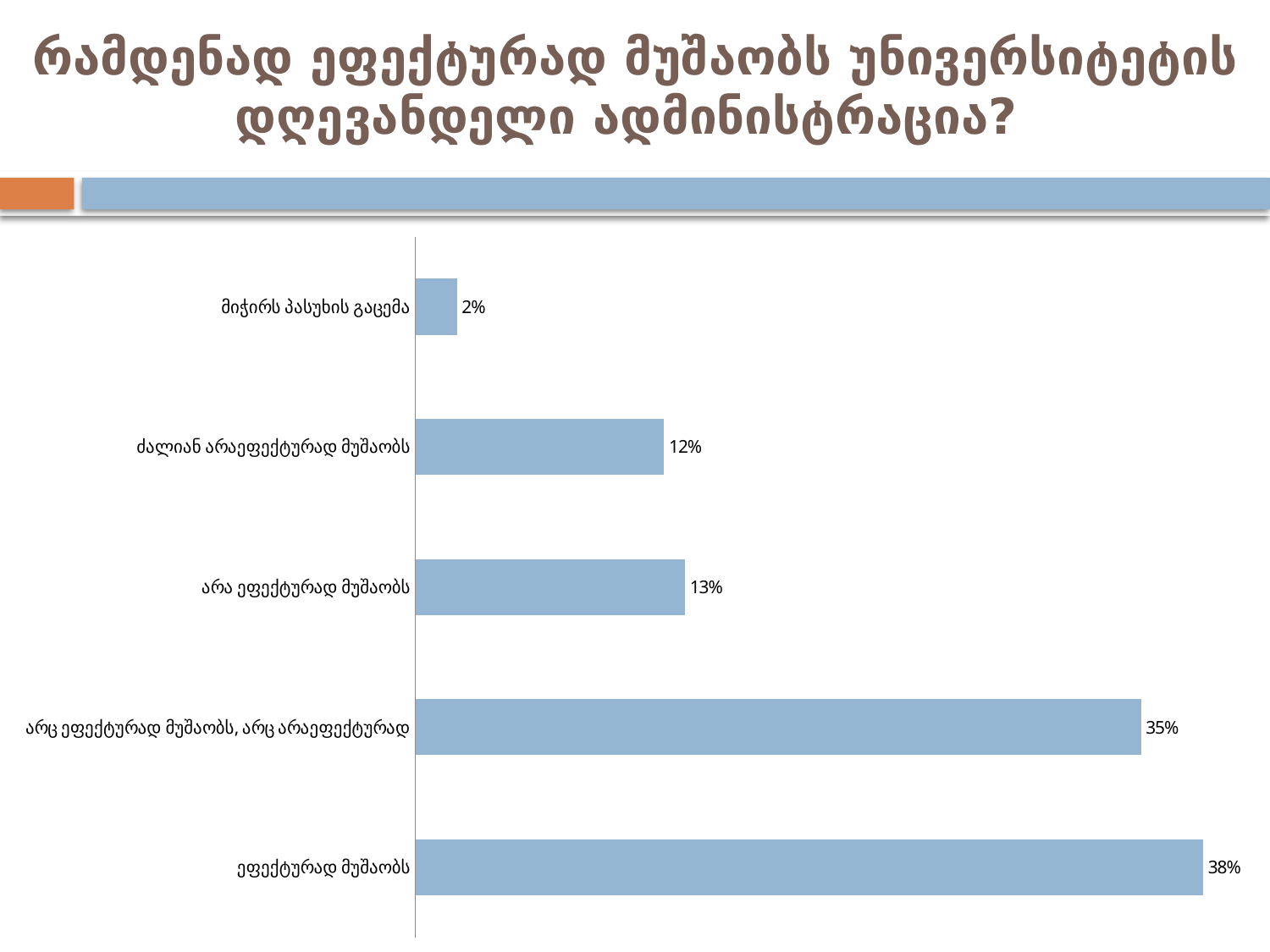
What value is shown for "არც ეფექტურად მუშაობს, არც არაეფექტურად"? 35% What is the difference between the values for "ეფექტურად მუშაობს" and "არც ეფექტურად მუშაობს, არც არაეფექტურად"? 3% What is the title of the slide? რამდენად ეფექტურად მუშაობს უნივერსიტეტის დღევანდელი ადმინისტრაცია? How many categories are shown in the chart? 5 Which category has the highest value? ეფექტურად მუშაობს What value is shown for "ძალიან არაეფექტურად მუშაობს"? 12% What kind of chart is shown on the slide? Bar chart Which category has the lowest value? მიჭირს პასუხის გაცემა What value is shown for "ეფექტურად მუშაობს"? 38% What is the difference between the values for "არა ეფექტურად მუშაობს" and "ძალიან არაეფექტურად მუშაობს"? 1% What value is shown for "მიჭირს პასუხის გაცემა"? 2% Which is larger, the value for "არა ეფექტურად მუშაობს" or the value for "მიჭირს პასუხის გაცემა"? არა ეფექტურად მუშაობს